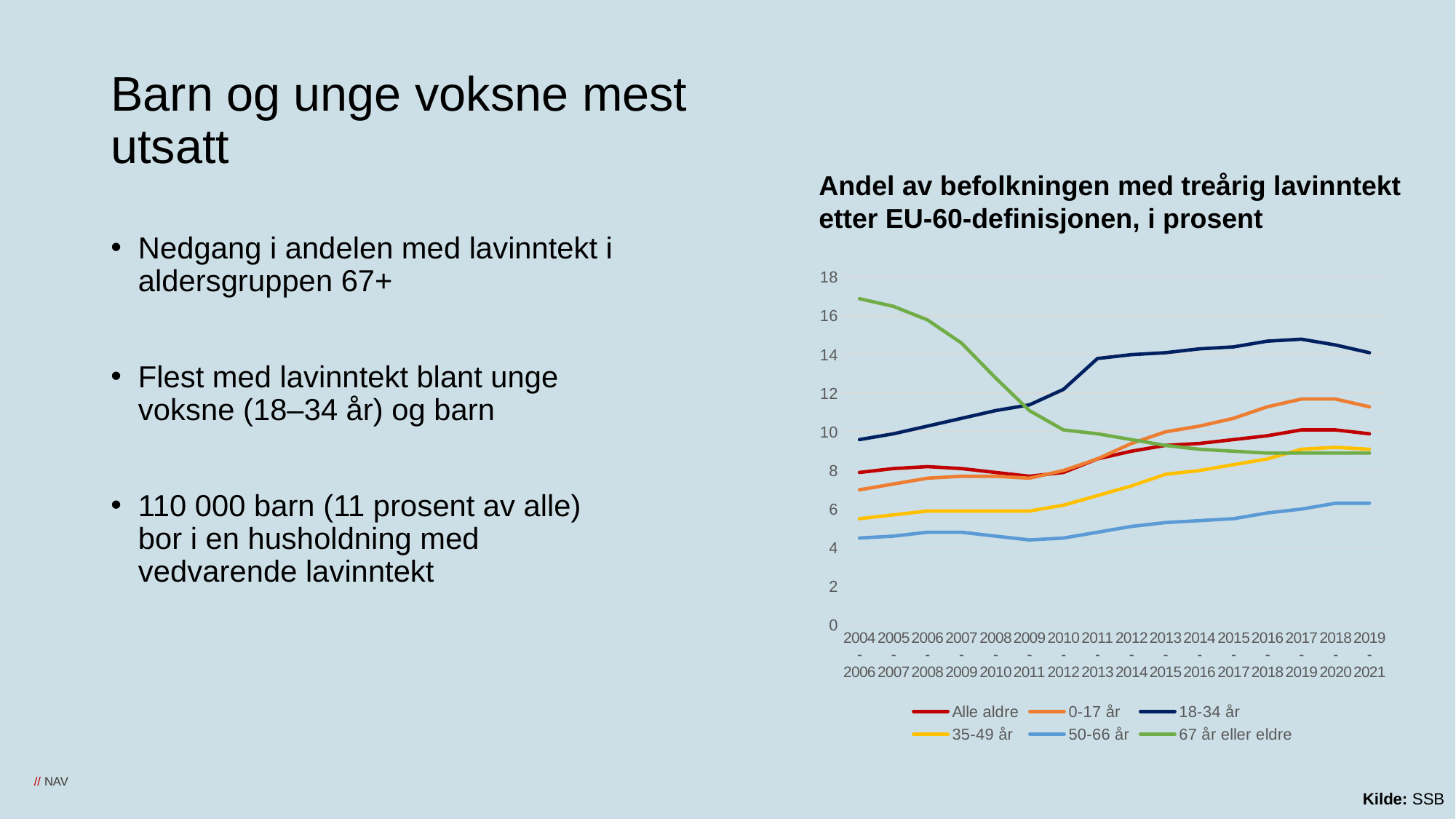
What kind of chart is shown on the slide? Line chart Which series has the highest value in the 2019-2021 period? 18-34 år How many three-year periods are shown along the x axis of the chart? 16 Is the value for '67 år eller eldre' in 2004-2006 greater or less than 16? greater How many series does the legend of the chart list? 6 Which series has the lowest value in the 2019-2021 period? 50-66 år Does the value for '18-34 år' rise or fall from 2004-2006 to 2019-2021? Rise Does the value for '67 år eller eldre' rise or fall from 2004-2006 to 2019-2021? Fall What is the title of the chart? Andel av befolkningen med treårig lavinntekt etter EU-60-definisjonen, i prosent In the 2019-2021 period, which is larger: the value for '18-34 år' or the value for '67 år eller eldre'? 18-34 år Is the value for '50-66 år' in 2019-2021 greater or less than 8? less Which series has the highest value in the 2004-2006 period? 67 år eller eldre